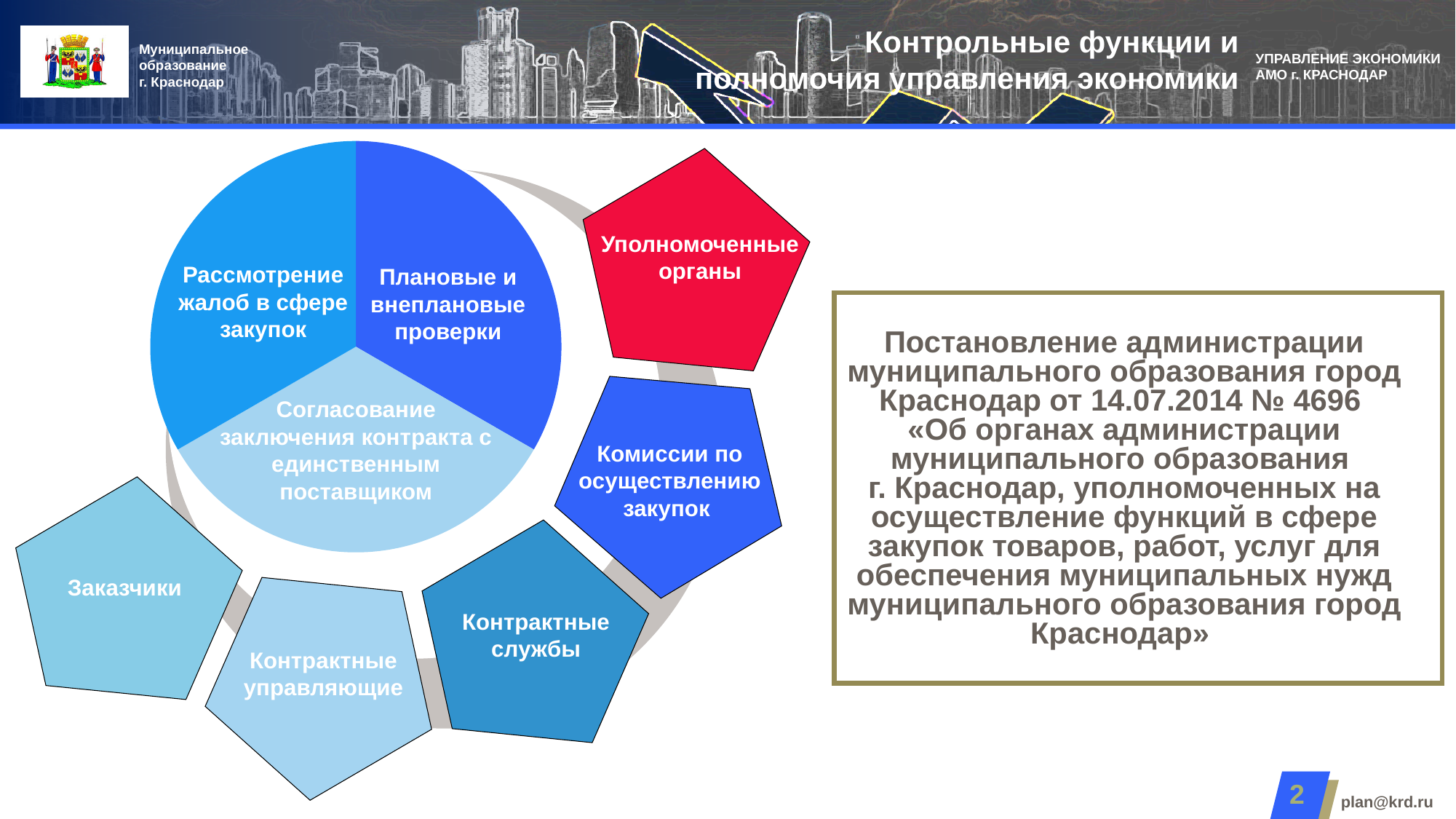
What is the label of the light blue segment at the bottom of the pie chart? Согласование заключения контракта с единственным поставщиком How many pentagon shapes surround the pie chart on the slide? 5 What is the label of the dark blue segment on the right side of the pie chart? Плановые и внеплановые проверки What is the label of the segment on the upper left of the pie chart? Рассмотрение жалоб в сфере закупок What kind of chart is shown on the left side of the slide? pie chart How many segments does the pie chart on the left of the slide have? 3 Are any numeric values printed on the segments of the pie chart? No